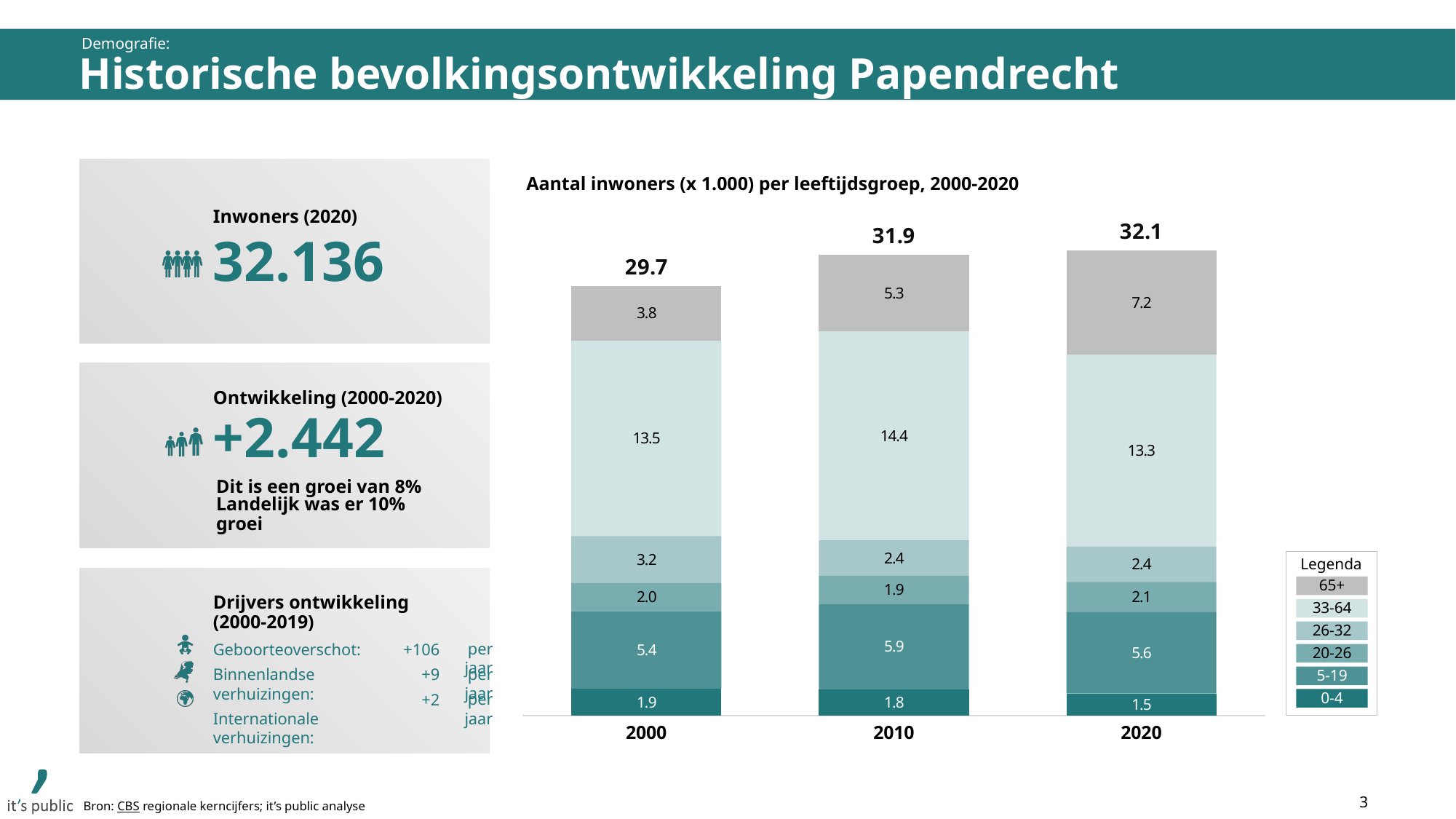
What is the value for the 65+ age group in 2020? 7.2 What is the value for the 0-4 age group in 2000? 1.9 What is the difference between the 65+ values for 2020 and 2000? 3.4 What is the total of the stacked bar for 2010? 31.9 What is the value for the 33-64 age group in 2010? 14.4 Does the 0-4 age group value rise or fall from 2000 to 2020? fall How many years (categories) are shown on the x axis? 3 How many age groups does the legend list? 6 What type of chart is shown on the slide? stacked bar chart Which is larger: the 5-19 value in 2010 or the 5-19 value in 2020? 2010 Which year has the highest total number of inhabitants? 2020 Which year has the lowest total number of inhabitants? 2000